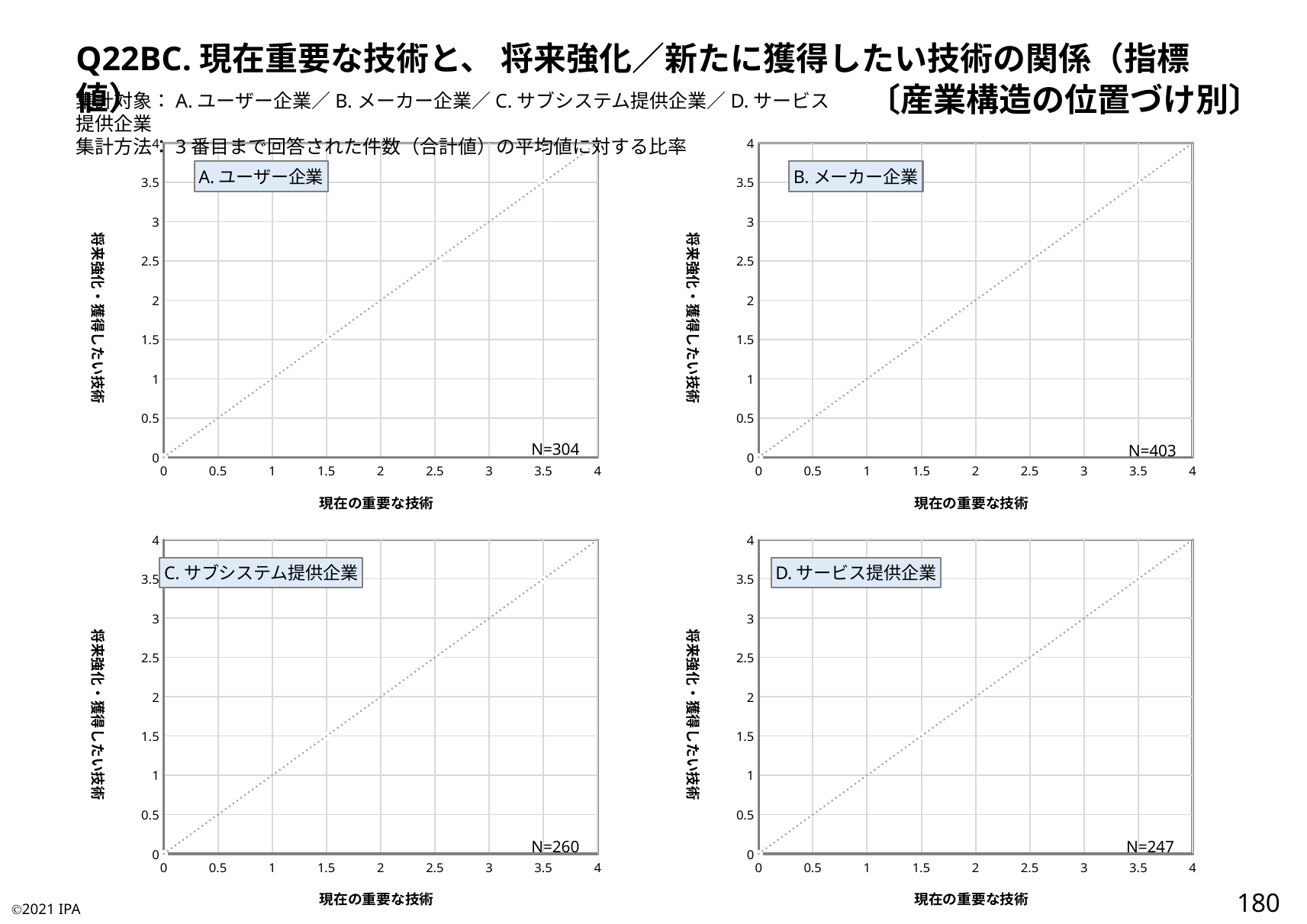
Which of the four charts has the largest N value? B. メーカー企業 What is the N value shown on the chart labelled D. サービス提供企業? N=247 What is the difference between the N value of the B. メーカー企業 chart and the N value of the A. ユーザー企業 chart? 99 What is the N value shown on the chart labelled B. メーカー企業? N=403 What is the N value shown on the chart labelled C. サブシステム提供企業? N=260 What is the maximum value shown on the x axis of the A. ユーザー企業 chart? 4 What is the N value shown on the chart labelled A. ユーザー企業? N=304 Is the N value of the C. サブシステム提供企業 chart larger than the N value of the D. サービス提供企業 chart? Yes Which of the four charts has the smallest N value? D. サービス提供企業 How many charts are shown on the slide? 4